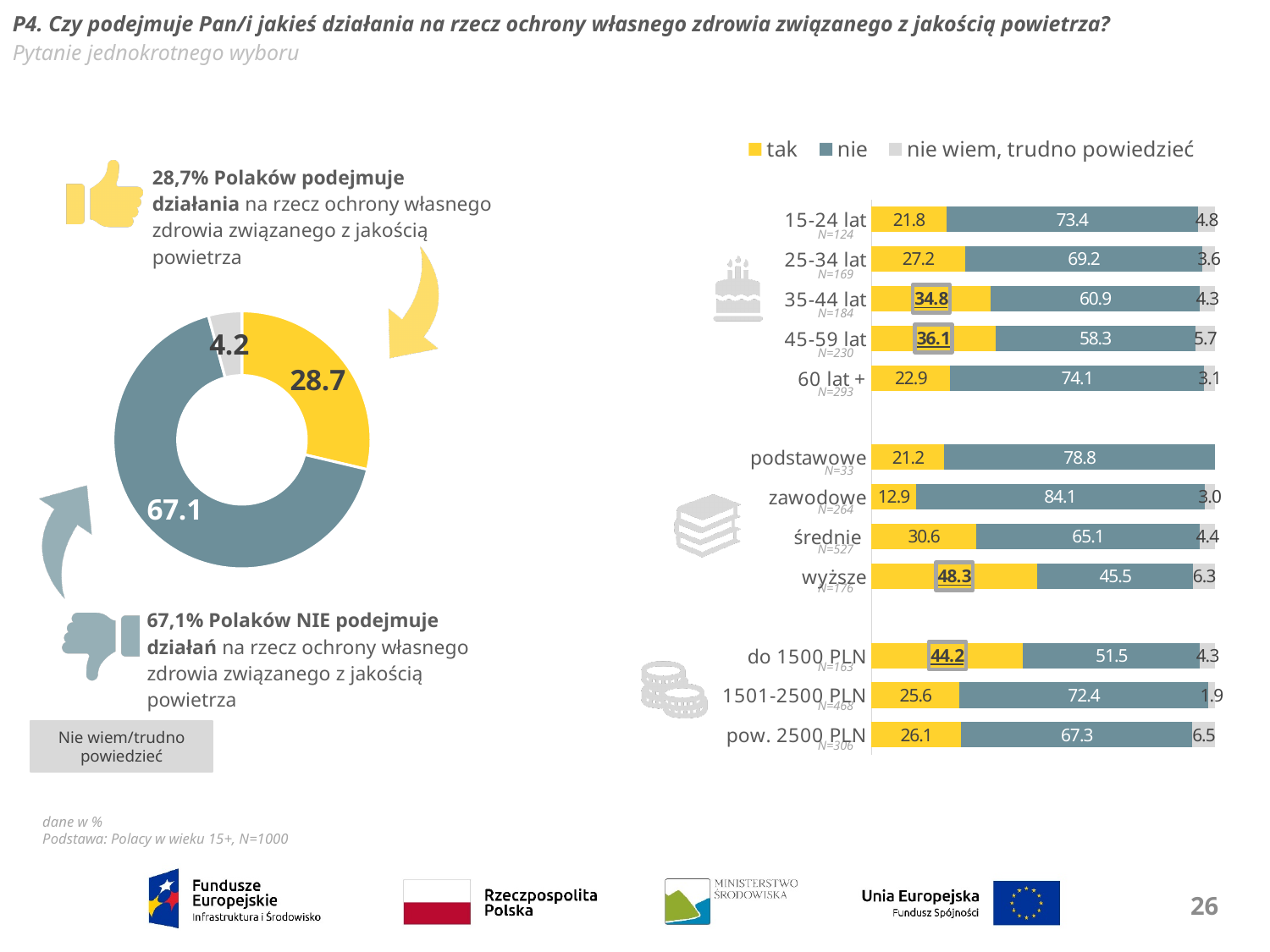
In the stacked bar chart on the right, what is the difference between the 'tak' values for 'wyższe' and 'zawodowe'? 35.4 In the stacked bar chart on the right, what is the total of the three segments for the '1501-2500 PLN' bar? 99.9 How many groups (bars) are shown in the stacked bar chart on the right? 12 In the stacked bar chart on the right, what is the value of 'nie' for the 'zawodowe' group? 84.1 In the stacked bar chart on the right, what is the value of 'tak' for the 35-44 lat group? 34.8 What kind of chart is the chart on the right side of the slide? Stacked bar chart In the stacked bar chart on the right, what is the value of 'nie wiem, trudno powiedzieć' for the 'pow. 2500 PLN' group? 6.5 In the stacked bar chart on the right, which group has the highest 'tak' value? wyższe In the stacked bar chart on the right, which group has the lowest 'tak' value? zawodowe How many series does the legend of the stacked bar chart on the right list? 3 In the donut chart on the left, what is the value of the largest slice? 67.1 In the stacked bar chart on the right, which group has a larger 'nie' value: '60 lat +' or '15-24 lat'? 60 lat +